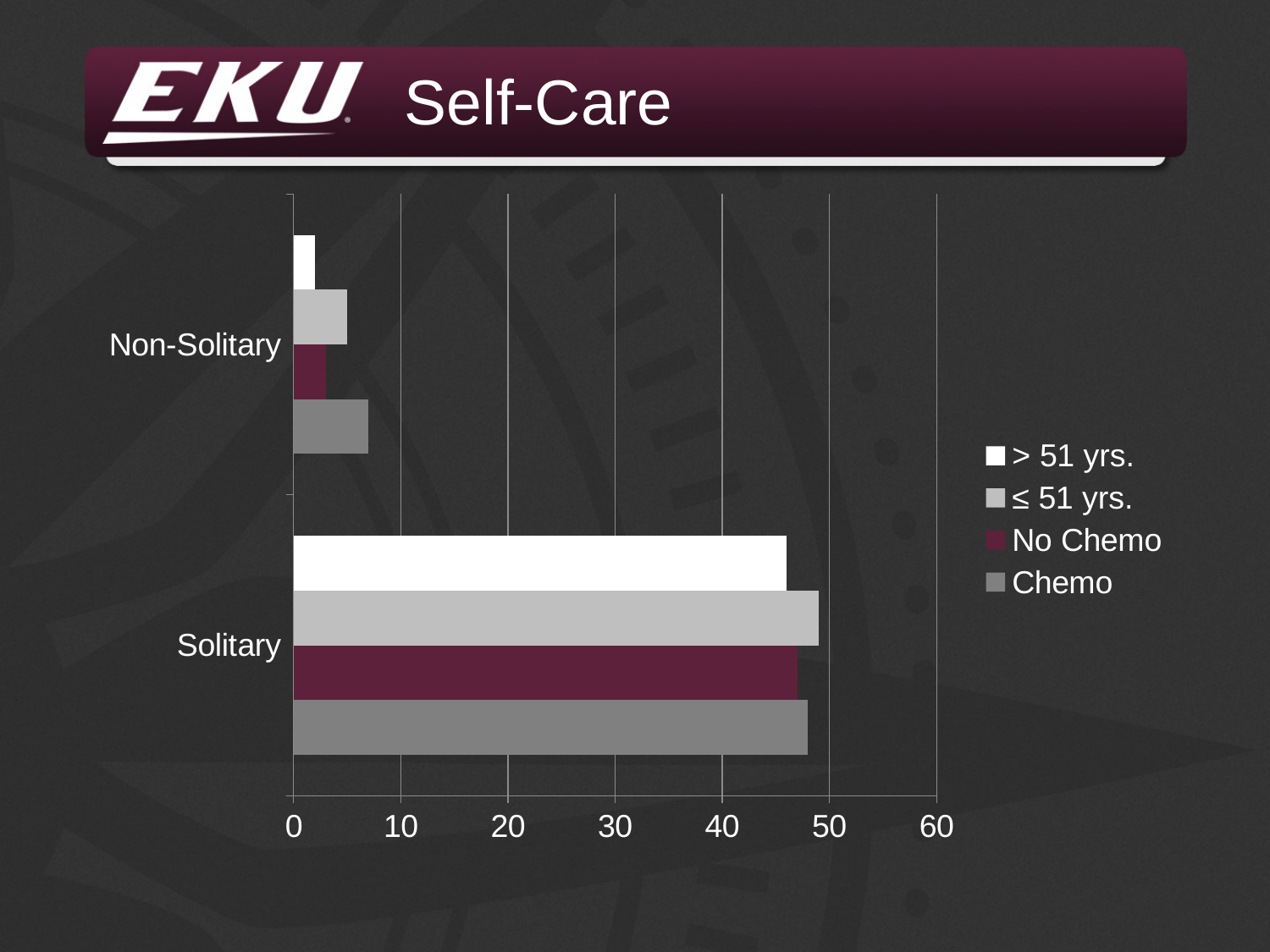
Which category has the lowest value in the ≤ 51 yrs. series? Non-Solitary Is the value for Non-Solitary in the > 51 yrs. series greater or less than 10? less Which series is shown in white in the chart? > 51 yrs. What is the title of the slide containing the chart? Self-Care Is the value for Solitary in the > 51 yrs. series greater or less than 40? greater Which category has the higher value in the Chemo series, Solitary or Non-Solitary? Solitary Within the Non-Solitary category, which is larger: the Chemo value or the > 51 yrs. value? Chemo Is the value for Solitary in the Chemo series greater or less than 40? greater How many series does the chart's legend list? 4 What kind of chart is shown on the slide? bar chart How many categories are shown on the vertical axis of the chart? 2